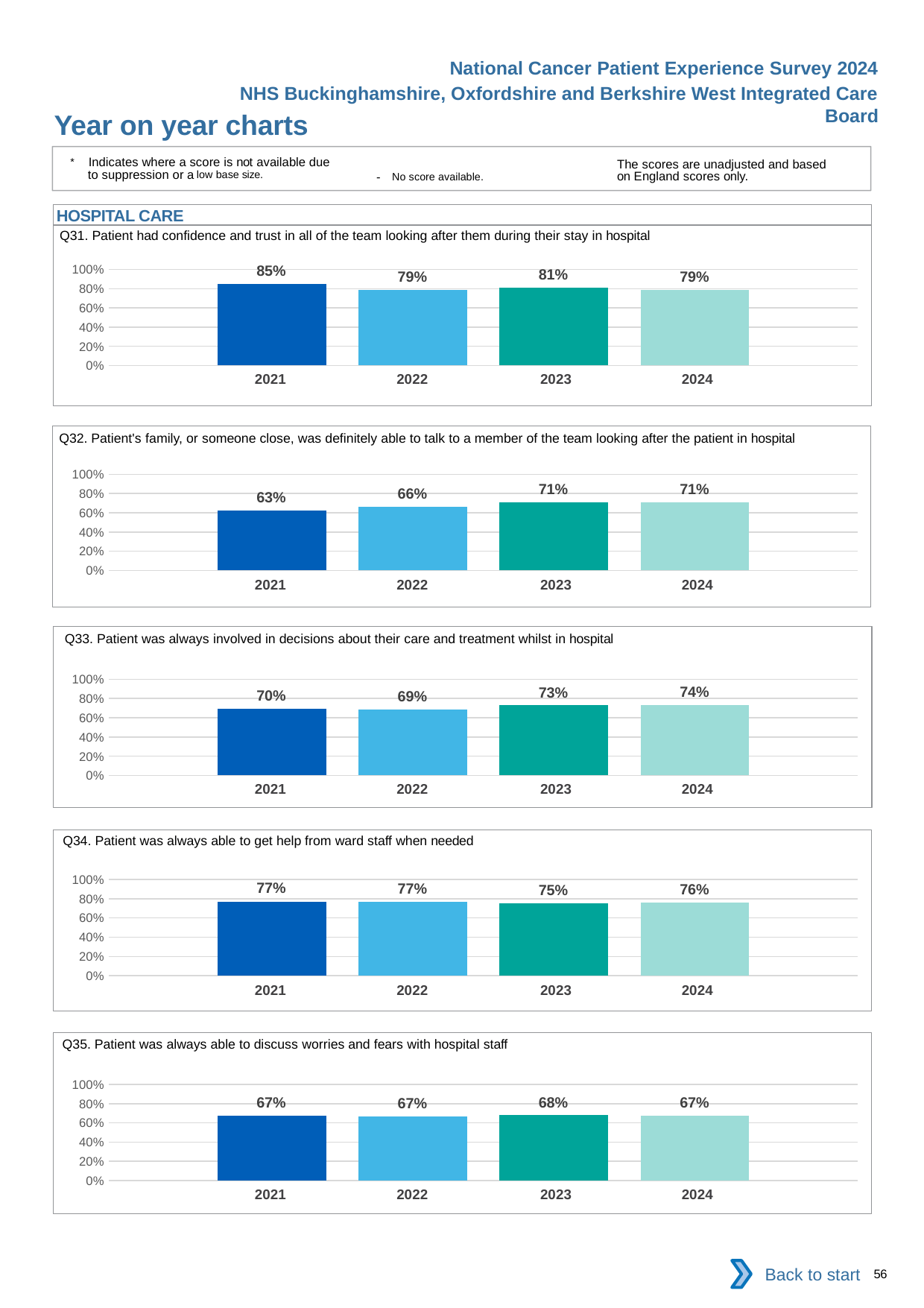
In the Q31 chart, which is larger, the value for 2022 or the value for 2023? 2023 In the Q31 chart, what is the difference between the 2021 value and the 2024 value? 6% In the Q35 chart, which year has the highest value? 2023 In the Q34 chart, what is the value for 2023? 75% In the Q32 chart, which year has the lowest value? 2021 In the Q32 chart, how many years are plotted? 4 In the Q33 chart, what is the difference between the 2024 value and the 2021 value? 4% In the Q34 chart, is the value for 2021 greater or less than 60%? greater In the Q35 chart, what is the value for 2022? 67% What kind of chart is the Q33 chart? bar chart In the Q32 chart, do the values generally rise or fall from 2021 to 2024? rise In the Q31 chart, what is the value for 2021? 85%